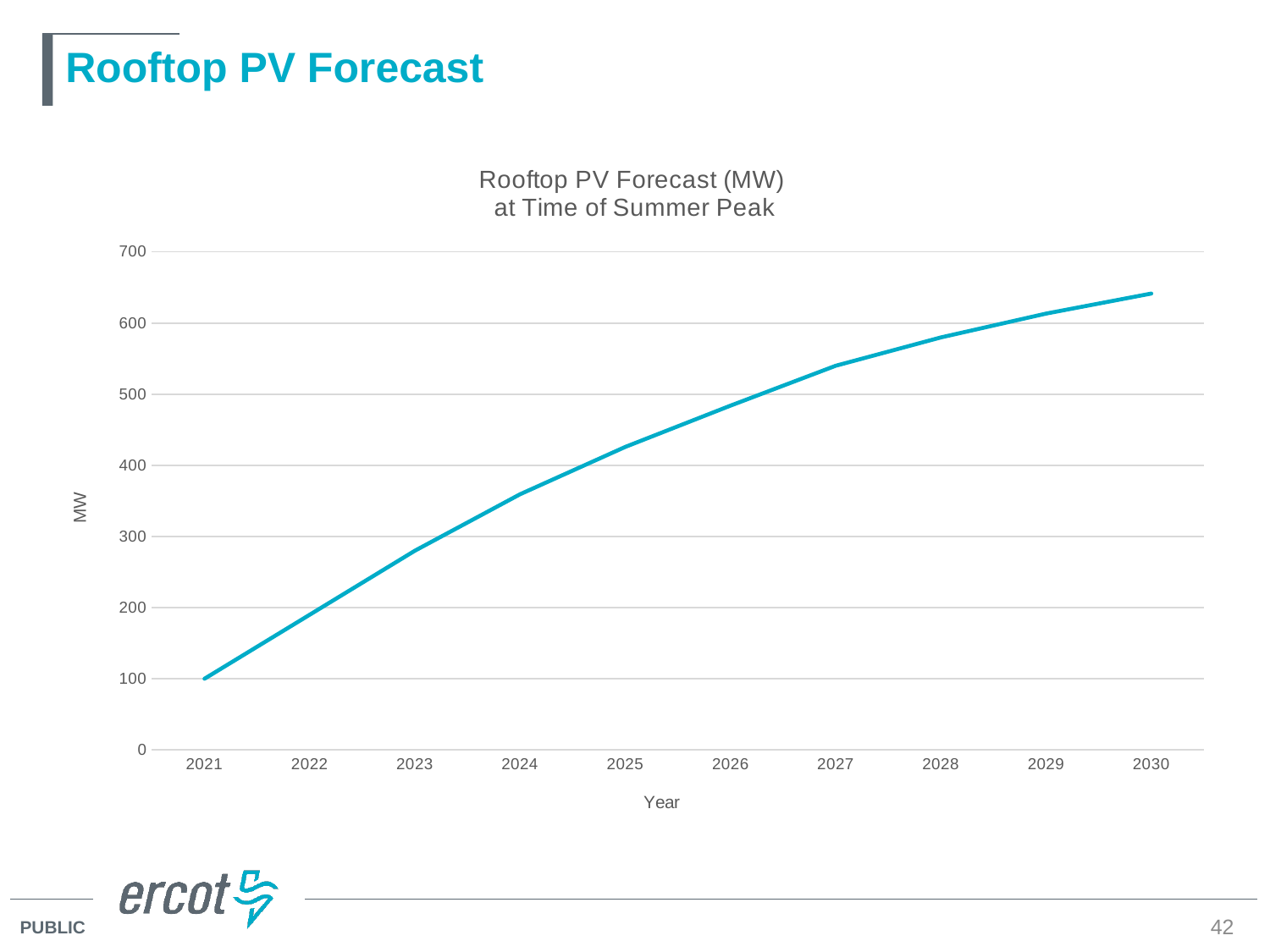
How many years are plotted along the x axis? 10 Which year has the lowest rooftop PV forecast value? 2021 What is the rooftop PV forecast value for 2021? 100 Which year has the larger forecast value, 2024 or 2029? 2029 Do the forecast values rise or fall from 2021 to 2030? rise Is the value for 2025 greater or less than 400? greater Is the value for 2030 greater or less than 600? greater Is the value for 2023 greater or less than 300? less Which year has the highest rooftop PV forecast value? 2030 What is the label on the y axis of the chart? MW What kind of chart is shown on the slide? line chart